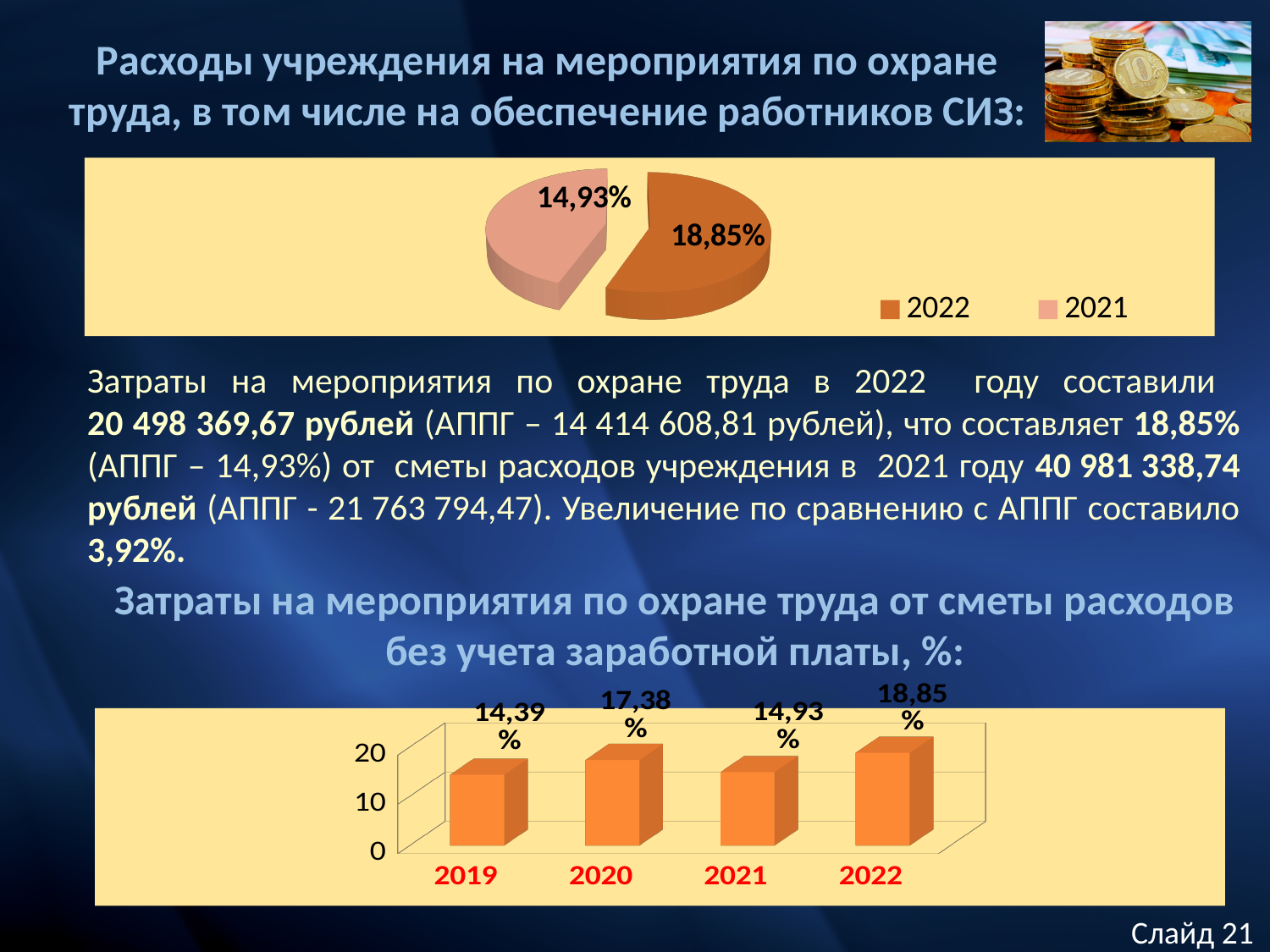
In the pie chart at the top of the slide, how many entries does the legend list? 2 In the bar chart at the bottom of the slide, which year has the lowest value? 2019 What kind of chart is shown at the bottom of the slide, under the title 'Затраты на мероприятия по охране труда от сметы расходов без учета заработной платы, %'? bar chart In the bar chart at the bottom of the slide, which year has the highest value? 2022 In the bar chart at the bottom of the slide, what is the difference between the values for 2022 and 2021? 3,92% In the pie chart at the top of the slide, what is the value shown for 2022? 18,85% In the bar chart at the bottom of the slide, what is the value for 2019? 14,39% In the pie chart at the top of the slide, what is the value shown for 2021? 14,93% In the bar chart at the bottom of the slide, what is the value for 2020? 17,38% In the bar chart at the bottom of the slide, how many years are shown on the x axis? 4 In the pie chart at the top of the slide, which year has the larger slice, 2022 or 2021? 2022 What kind of chart is shown at the top of the slide? pie chart